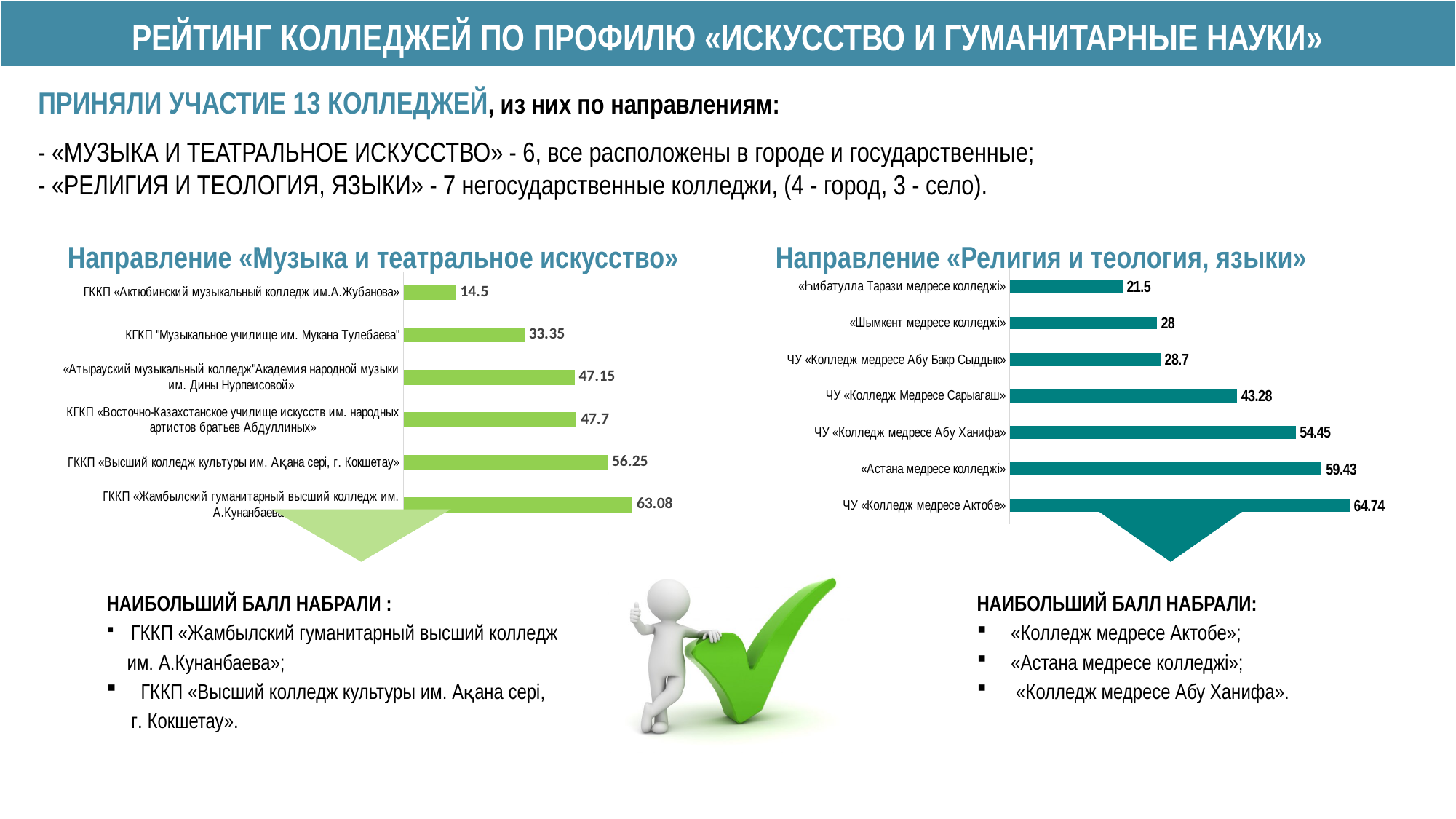
На диаграмме «Направление «Религия и теология, языки»» какое значение у «Астана медресе колледжі»? 59.43 На диаграмме «Направление «Музыка и театральное искусство»» какой колледж имеет наименьшее значение? ГККП «Актюбинский музыкальный колледж им.А.Жубанова» Какого типа диаграмма «Направление «Религия и теология, языки»»? Столбчатая (bar chart) На диаграмме «Направление «Религия и теология, языки»» у кого значение больше: у «Шымкент медресе колледжі» или у ЧУ «Колледж медресе Абу Ханифа»? ЧУ «Колледж медресе Абу Ханифа» На диаграмме «Направление «Музыка и театральное искусство»» какое значение у ГККП «Актюбинский музыкальный колледж им.А.Жубанова»? 14.5 На диаграмме «Направление «Музыка и театральное искусство»» какое значение у ГККП «Высший колледж культуры им. Ақана сері, г. Кокшетау»? 56.25 На диаграмме «Направление «Религия и теология, языки»» какое значение у ЧУ «Колледж Медресе Сарыагаш»? 43.28 На диаграмме «Направление «Религия и теология, языки»» какой колледж имеет наибольшее значение? ЧУ «Колледж медресе Актобе» На диаграмме «Направление «Музыка и театральное искусство»» какой колледж имеет наибольшее значение? ГККП «Жамбылский гуманитарный высший колледж им. А.Кунанбаева» Сколько колледжей показано на диаграмме «Направление «Музыка и театральное искусство»»? 6 На диаграмме «Направление «Музыка и театральное искусство»» на сколько значение ГККП «Жамбылский гуманитарный высший колледж им. А.Кунанбаева» больше значения КГКП "Музыкальное училище им. Мукана Тулебаева"? 29.73 На диаграмме «Направление «Религия и теология, языки»» какой колледж имеет наименьшее значение? «Һибатулла Тарази медресе колледжі»